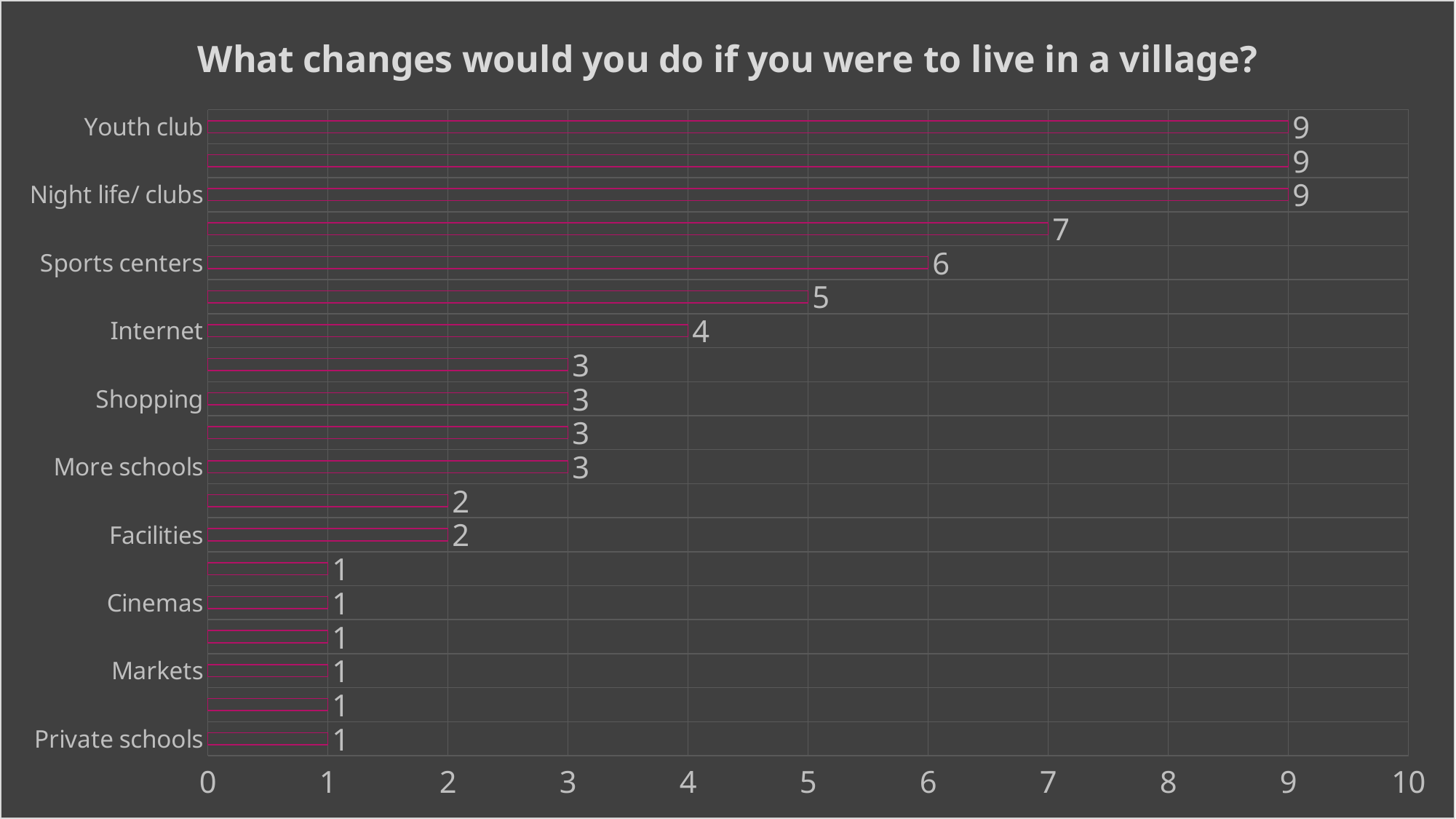
What is the value for More schools? 3 Which has a larger value, Sports centers or Shopping? Sports centers Is the value for Night life/ clubs greater or less than 5? greater What is the title of the chart? What changes would you do if you were to live in a village? How many bars are plotted on the chart? 19 What is the value for Sports centers? 6 What is the value for Facilities? 2 What is the value for Internet? 4 What is the value for Private schools? 1 What is the value for Youth club? 9 What kind of chart is shown on the slide? bar chart What is the difference between the values for Youth club and Internet? 5